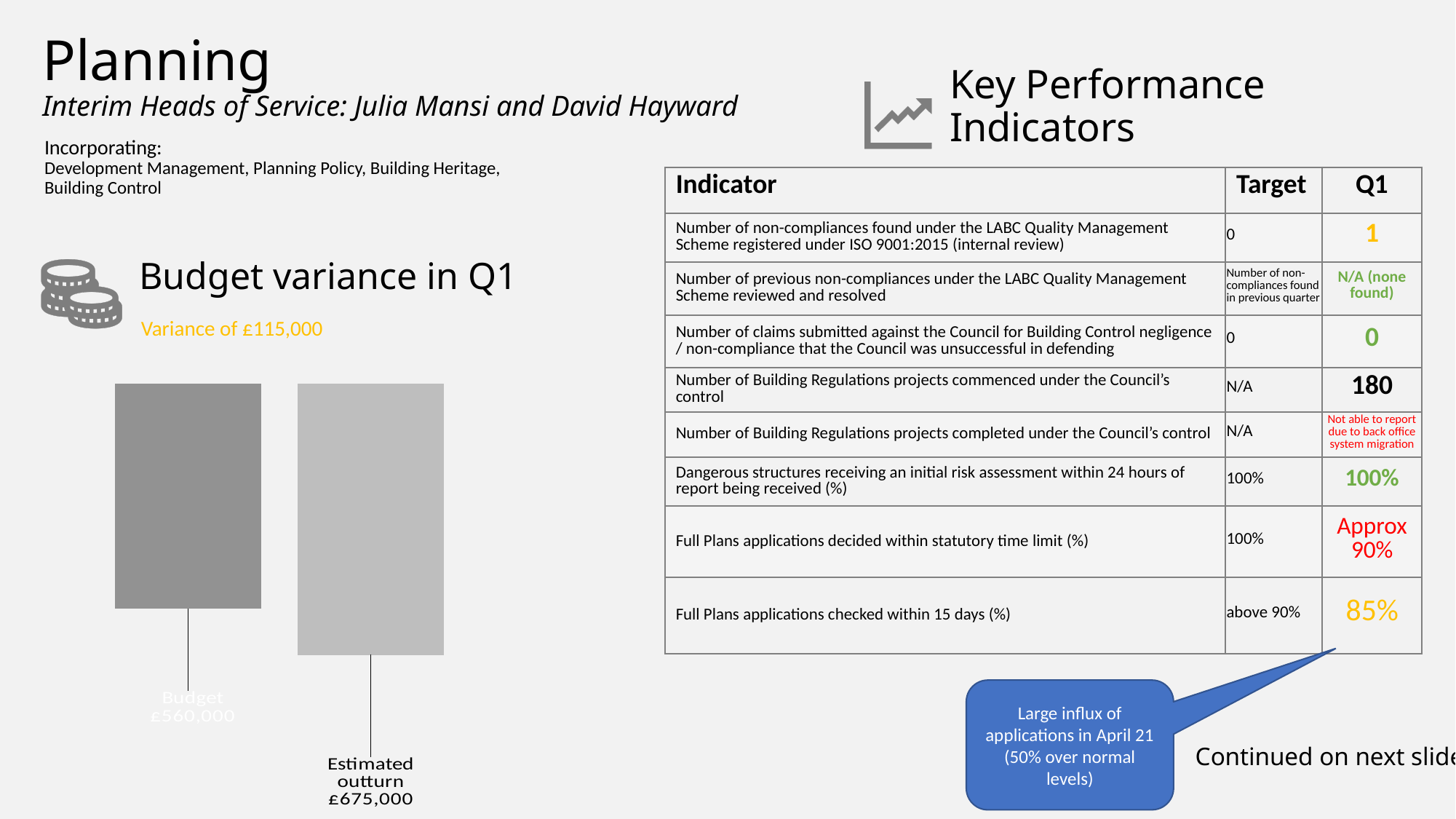
What type of chart is used to show the Budget variance in Q1? Bar chart What is the Estimated outturn value shown in the Budget variance in Q1 chart? £675,000 Which category has the highest value in the Budget variance in Q1 chart? Estimated outturn Which category has the lowest value in the Budget variance in Q1 chart? Budget In the Budget variance in Q1 chart, what is the difference between the Estimated outturn and the Budget? £115,000 How many bars are plotted in the Budget variance in Q1 chart? 2 What is the title of the chart on the left of the slide? Budget variance in Q1 In the Budget variance in Q1 chart, which is larger: the Budget or the Estimated outturn? Estimated outturn What is the Budget value shown in the Budget variance in Q1 chart? £560,000 What variance amount is stated above the Budget variance in Q1 chart? Variance of £115,000